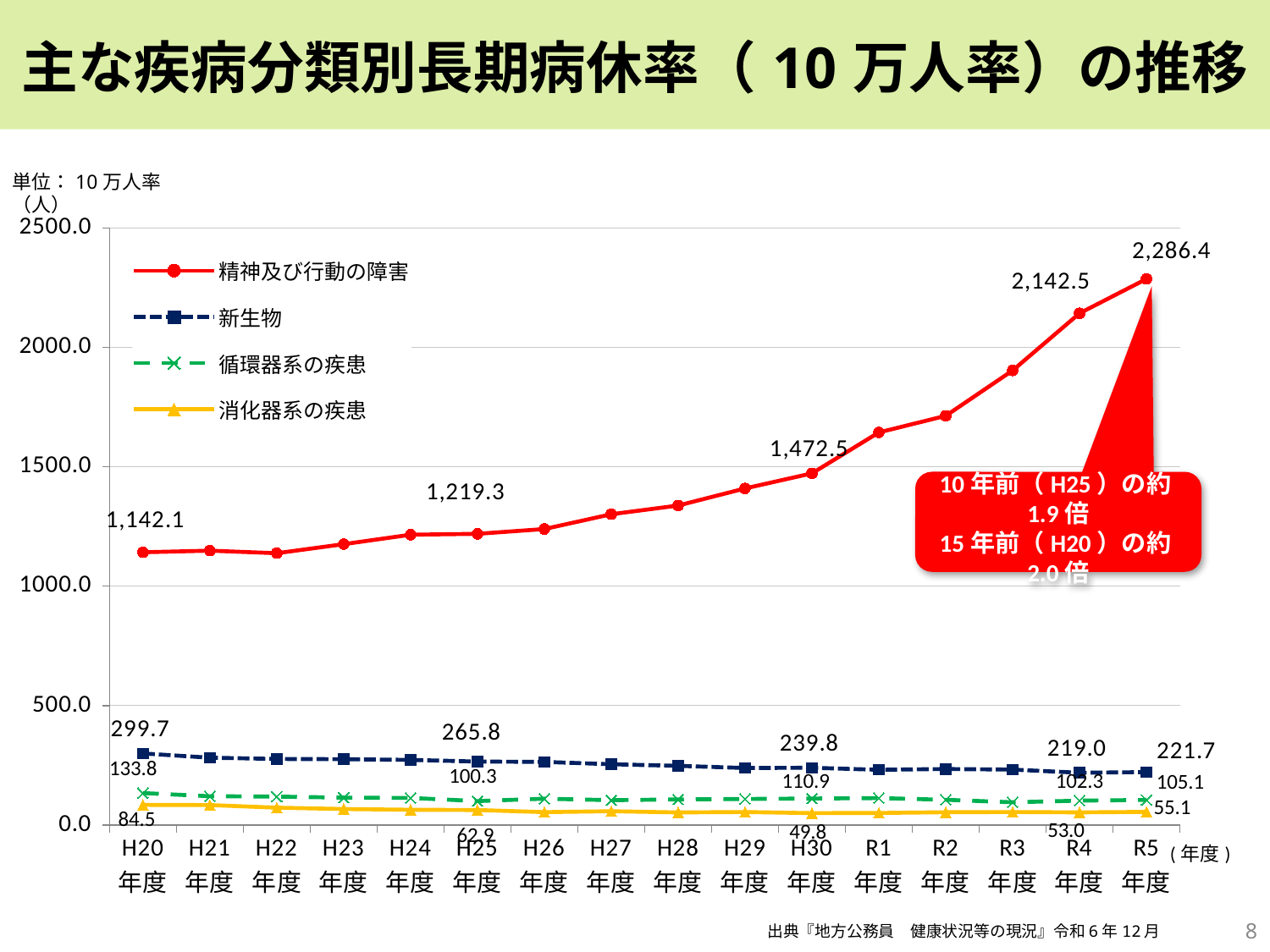
What kind of chart is shown on the slide? line chart Does the 精神及び行動の障害 series rise or fall from H20年度 to R5年度? rise What is the value for 循環器系の疾患 in H30年度? 110.9 How many fiscal years are plotted along the x axis? 16 What is the value for 新生物 in H20年度? 299.7 What is the value for 精神及び行動の障害 in R5年度? 2,286.4 Which series has the lowest value in H20年度? 消化器系の疾患 How many series does the legend list? 4 What is the value for 消化器系の疾患 in H25年度? 62.9 Which series has the highest value in R5年度? 精神及び行動の障害 What is the difference between the 精神及び行動の障害 values in R5年度 and R4年度? 143.9 Is the value for 精神及び行動の障害 in R3年度 greater or less than 2000.0? less